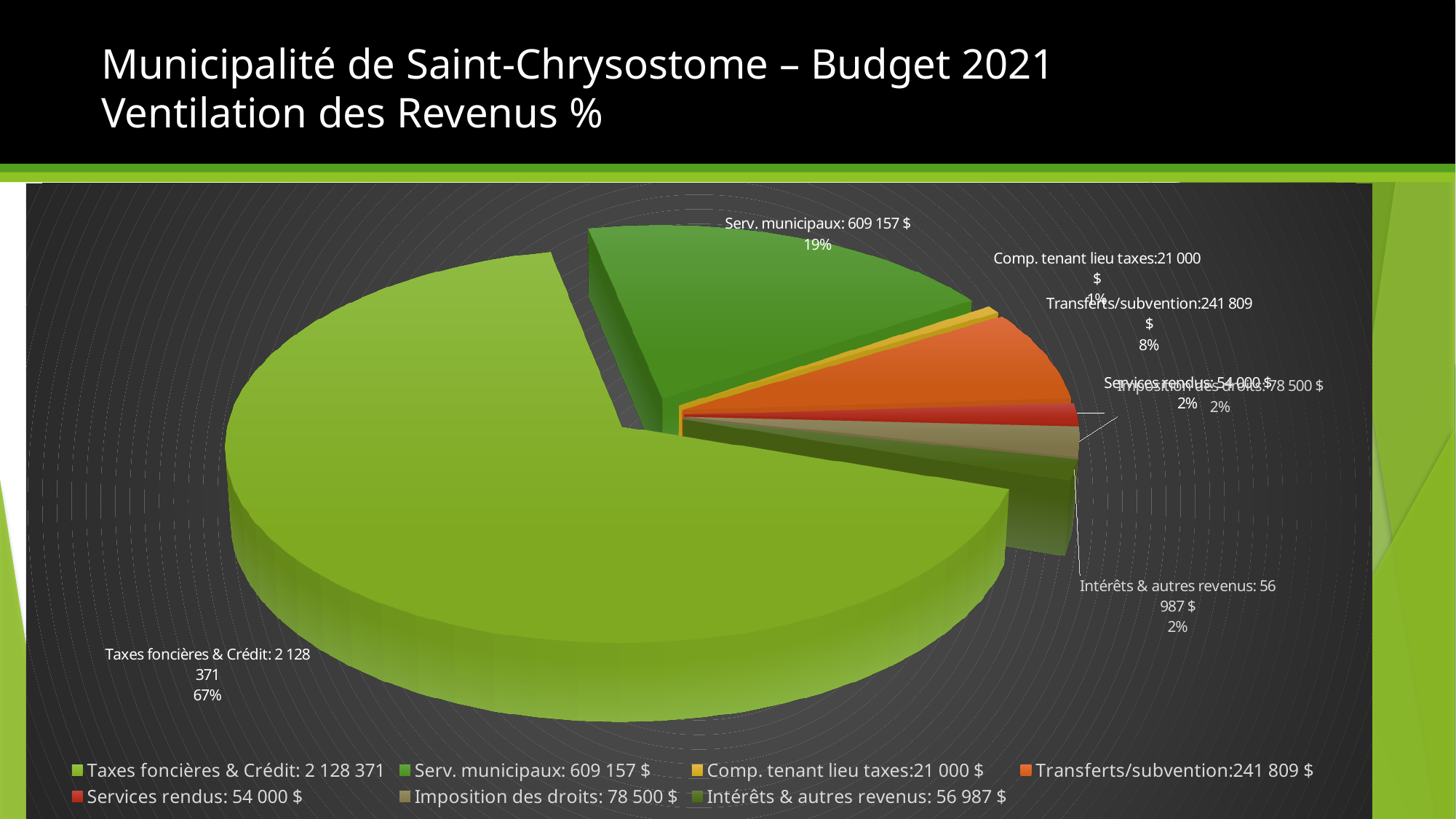
What share of the pie does Intérêts & autres revenus represent? 2% What share of the pie does Transferts/subvention represent? 8% How many slices does the pie chart have? 7 What share of the pie does Serv. municipaux represent? 19% How many entries does the legend list? 7 Which category has the largest slice of the pie? Taxes foncières & Crédit Which is larger, the share for Serv. municipaux or the share for Transferts/subvention? Serv. municipaux What is the difference in percentage points between the Taxes foncières & Crédit share and the Serv. municipaux share? 48 Which category has the smallest slice of the pie? Comp. tenant lieu taxes What kind of chart is shown on the slide? pie chart